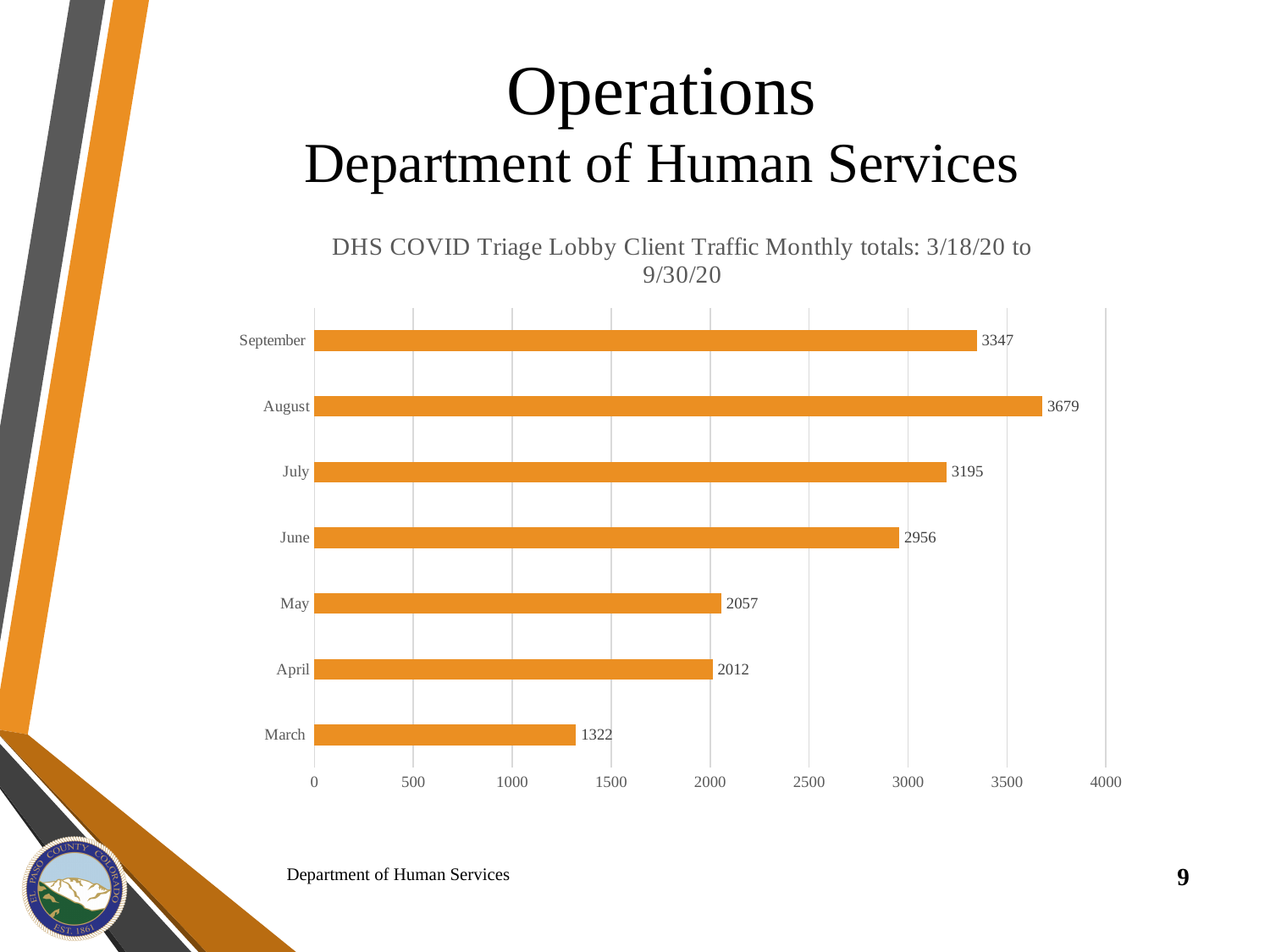
What is the value for June? 2956 What kind of chart is shown on the slide? Bar chart How many months are shown in the chart? 7 What is the difference between the values for August and September? 332 What is the title of the chart? DHS COVID Triage Lobby Client Traffic Monthly totals: 3/18/20 to 9/30/20 What is the difference between the values for May and April? 45 What is the value for August? 3679 Which month has the highest value? August What is the value for March? 1322 Which is larger, the value for July or the value for June? July Is the value for September greater or less than 3000? greater Which month has the lowest value? March